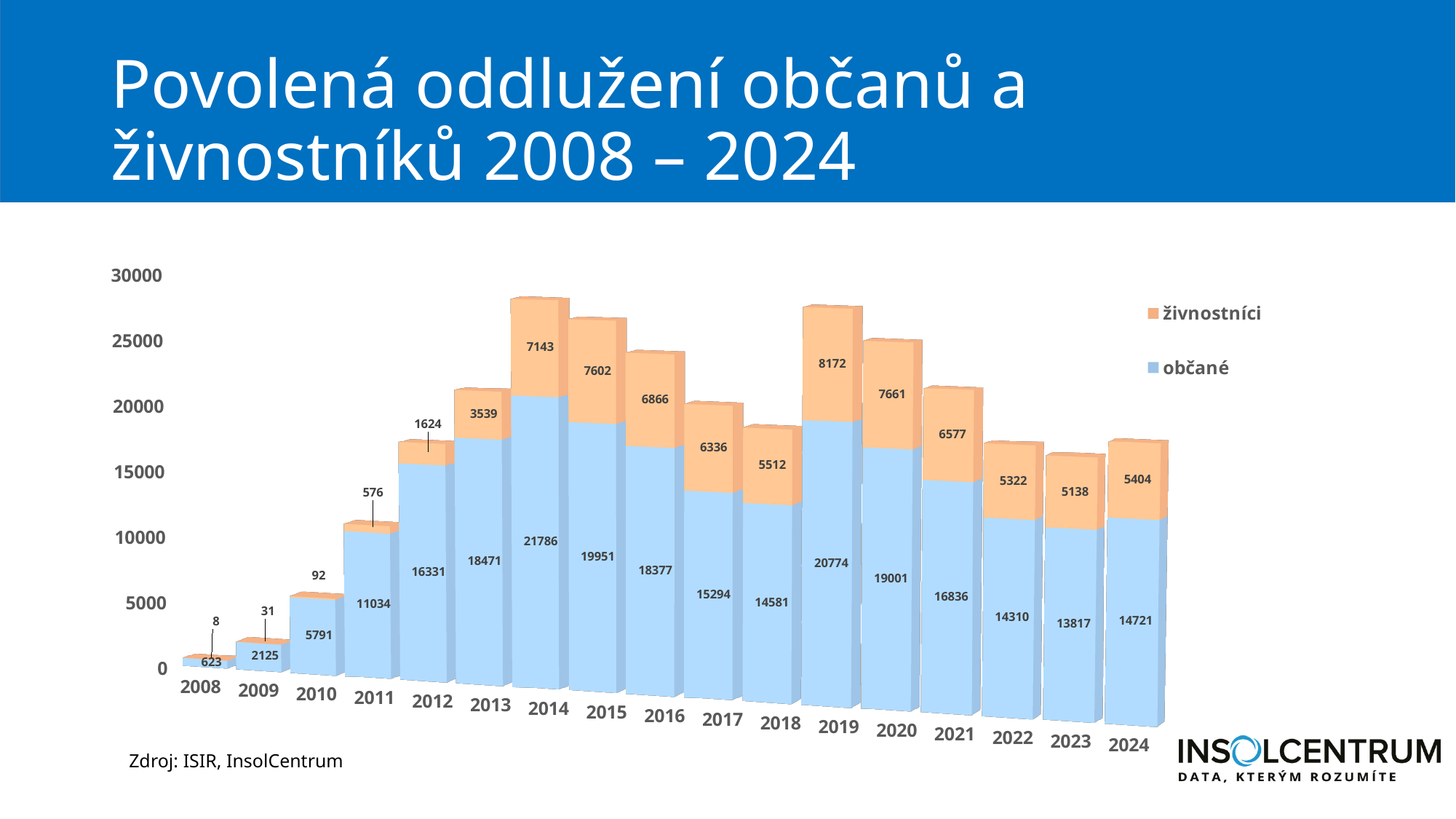
In which year is the value for živnostníci lowest? 2008 How many years are shown on the x axis? 17 What is the value for živnostníci in 2008? 8 Is the total of the stacked bar for 2012 greater or less than 15000? greater What type of chart is shown on the slide? stacked bar chart What is the difference between občané and živnostníci in 2024? 9317 What is the value for živnostníci in 2019? 8172 How many series does the legend list? 2 What is the total of the stacked bar for 2024? 20125 What is the value for občané in 2014? 21786 In which year is the value for občané highest? 2014 Which is larger, the value for občané in 2015 or in 2016? 2015